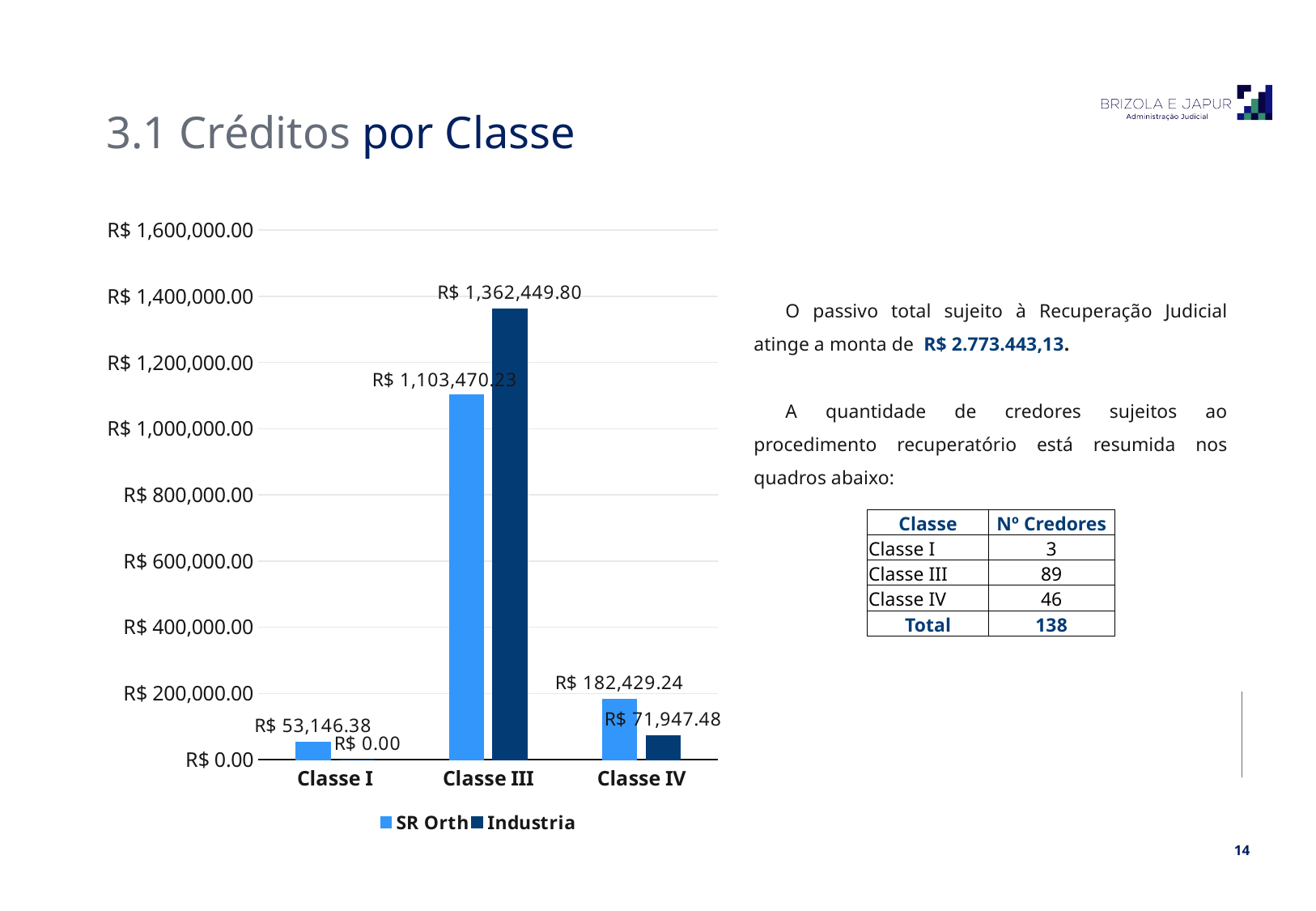
In Classe IV, which series has the larger value, SR Orth or Industria? SR Orth What is the value for SR Orth in Classe III? R$ 1,103,470.23 Which class has the highest value for Industria? Classe III How many classes are shown on the x axis of the chart? 3 What is the value for Industria in Classe IV? R$ 71,947.48 What is the value for SR Orth in Classe I? R$ 53,146.38 How many series does the chart legend list? 2 What is the difference between the Industria and SR Orth values in Classe III? R$ 258,979.57 What type of chart is shown on the slide? Bar chart Which class has the lowest value for SR Orth? Classe I What is the value for Industria in Classe III? R$ 1,362,449.80 Is the value for SR Orth in Classe IV greater or less than R$ 200,000.00? less